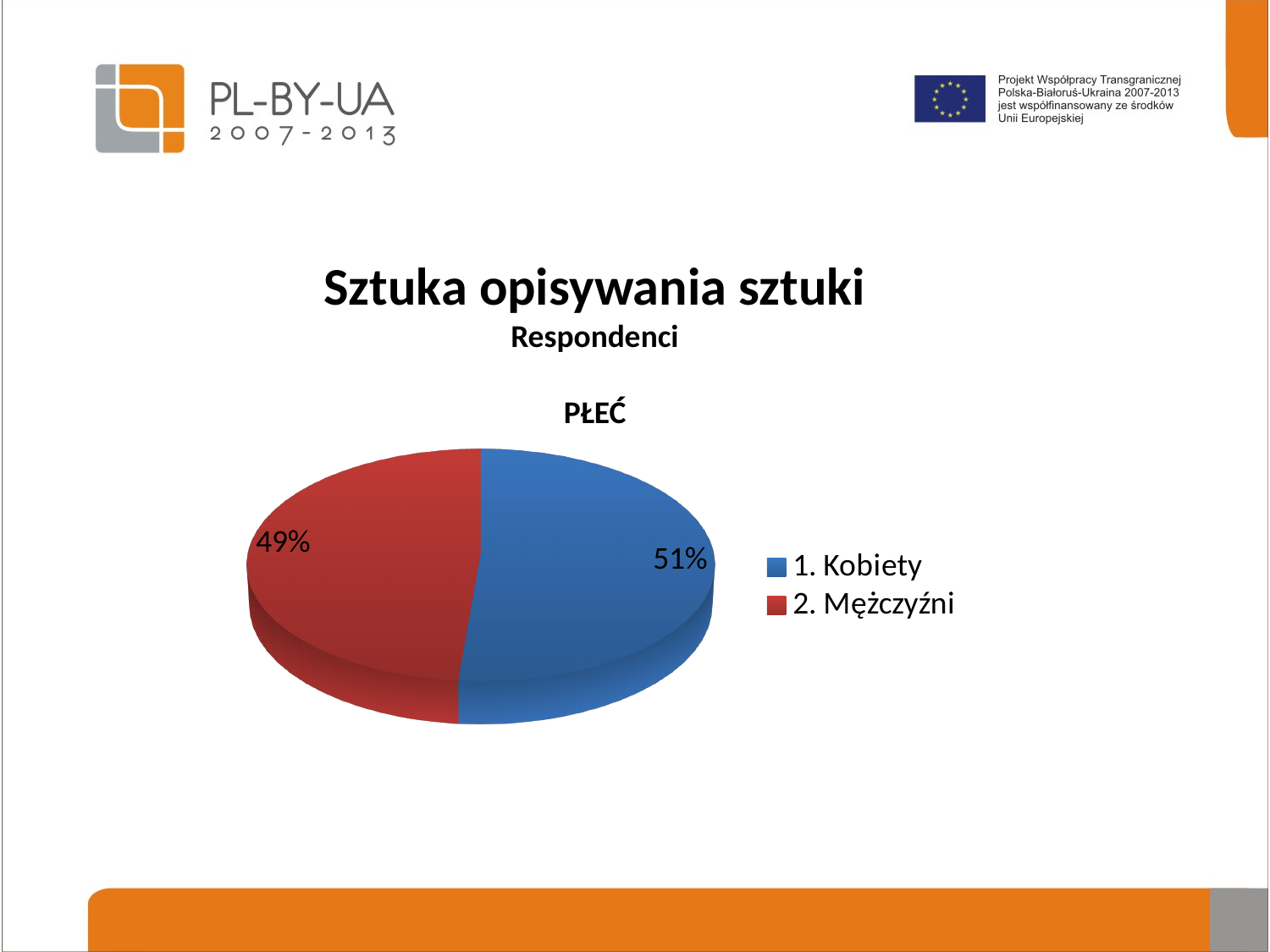
What share of the pie does 1. Kobiety have? 51% How many slices does the pie chart have? 2 How many entries does the legend list? 2 Which category has the smallest slice of the pie? 2. Mężczyźni What colour is the slice for 2. Mężczyźni? red Which category has the largest slice of the pie? 1. Kobiety Which is larger, the share for 1. Kobiety or for 2. Mężczyźni? 1. Kobiety What kind of chart is shown on the slide? pie chart What is the difference in percentage points between 1. Kobiety and 2. Mężczyźni? 2 What is the title of the chart? PŁEĆ What share of the pie does 2. Mężczyźni have? 49%